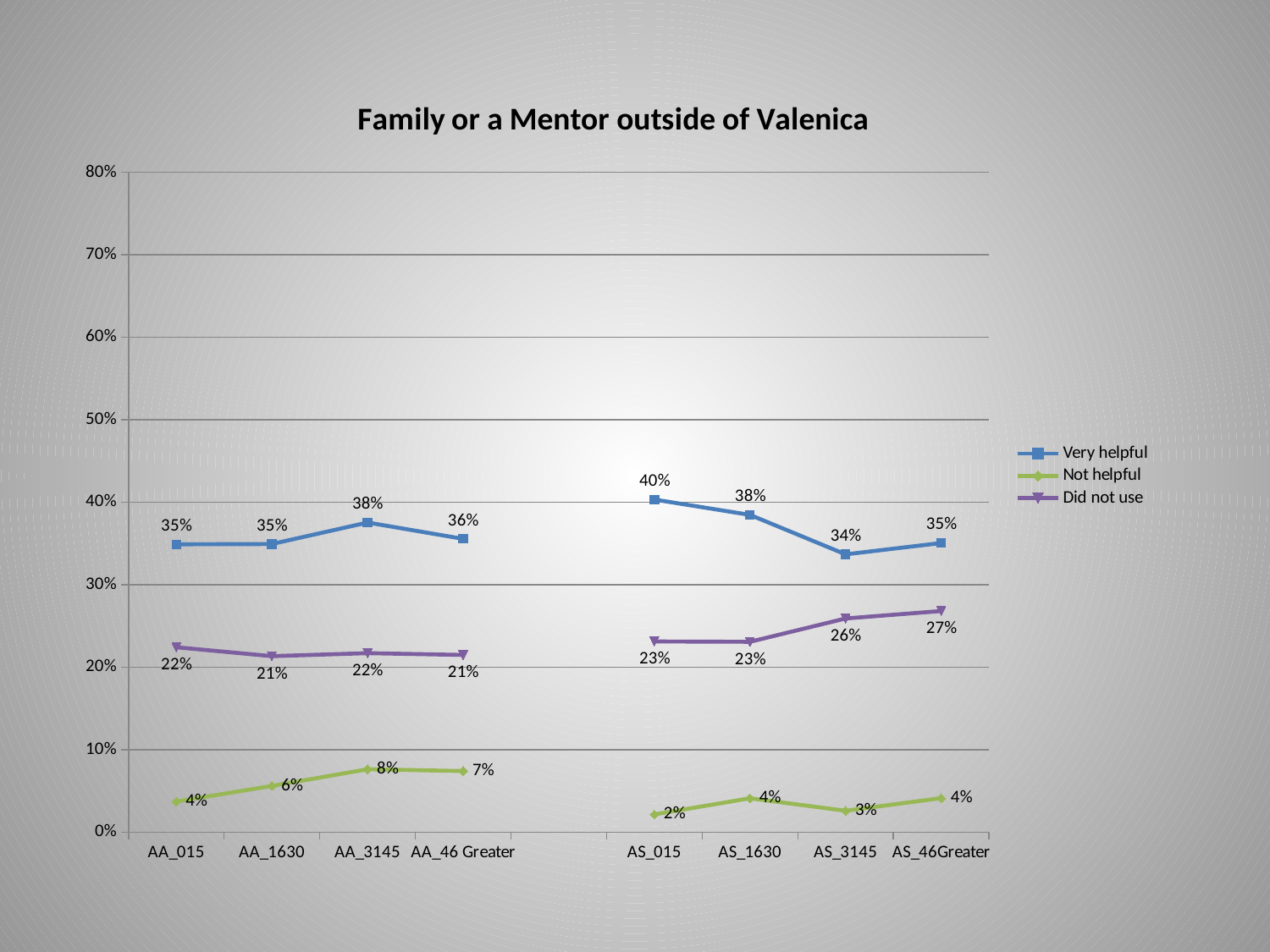
Which is larger, the Did not use value at AA_015 or at AS_3145? AS_3145 How many series does the legend list? 3 What kind of chart is shown on the slide? Line chart Is the value for Very helpful at AS_015 greater or less than 30%? greater What is the difference between the Very helpful value at AS_015 and at AS_3145? 6% Which category has the highest value for the Very helpful series? AS_015 Does the Did not use series rise or fall from AS_015 to AS_46Greater? Rise What is the title of the chart? Family or a Mentor outside of Valenica What is the value for Very helpful at AS_015? 40% What is the value for Did not use at AS_46Greater? 27% What is the value for Not helpful at AA_3145? 8% Which category has the lowest value for the Not helpful series? AS_015